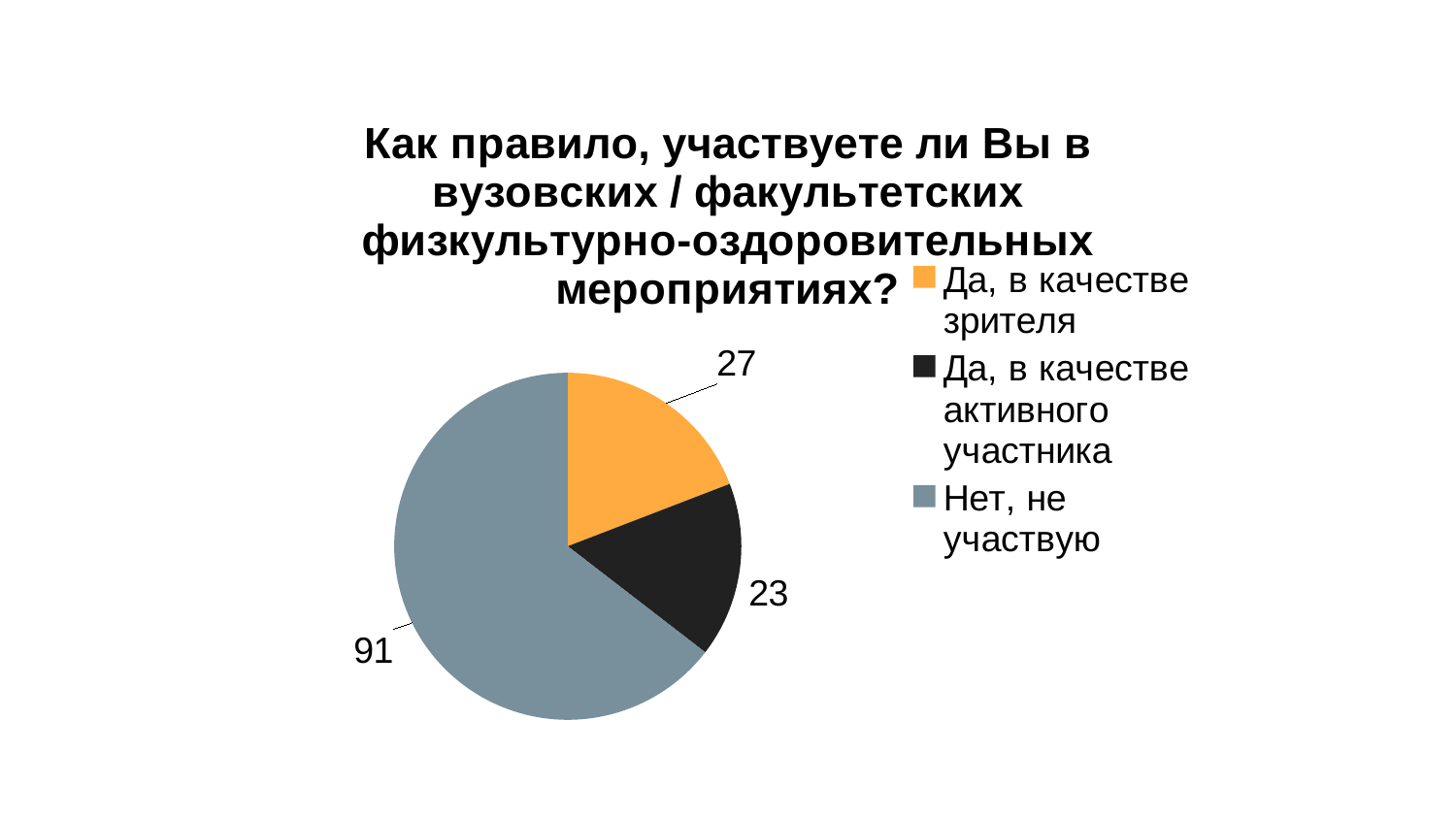
What colour is the slice for 'Нет, не участвую'? Grey What is the value for the slice 'Да, в качестве зрителя'? 27 How many slices does the pie chart have? 3 What is the difference between the values for 'Да, в качестве зрителя' and 'Да, в качестве активного участника'? 4 What is the difference between the values for 'Нет, не участвую' and 'Да, в качестве зрителя'? 64 What is the value for the slice 'Нет, не участвую'? 91 Which category has the smallest slice of the pie? Да, в качестве активного участника Which is larger: the value for 'Да, в качестве зрителя' or for 'Да, в качестве активного участника'? Да, в качестве зрителя What is the sum of all three values shown on the pie chart? 141 Which category has the largest slice of the pie? Нет, не участвую What is the value for the slice 'Да, в качестве активного участника'? 23 What type of chart is shown on the slide? Pie chart